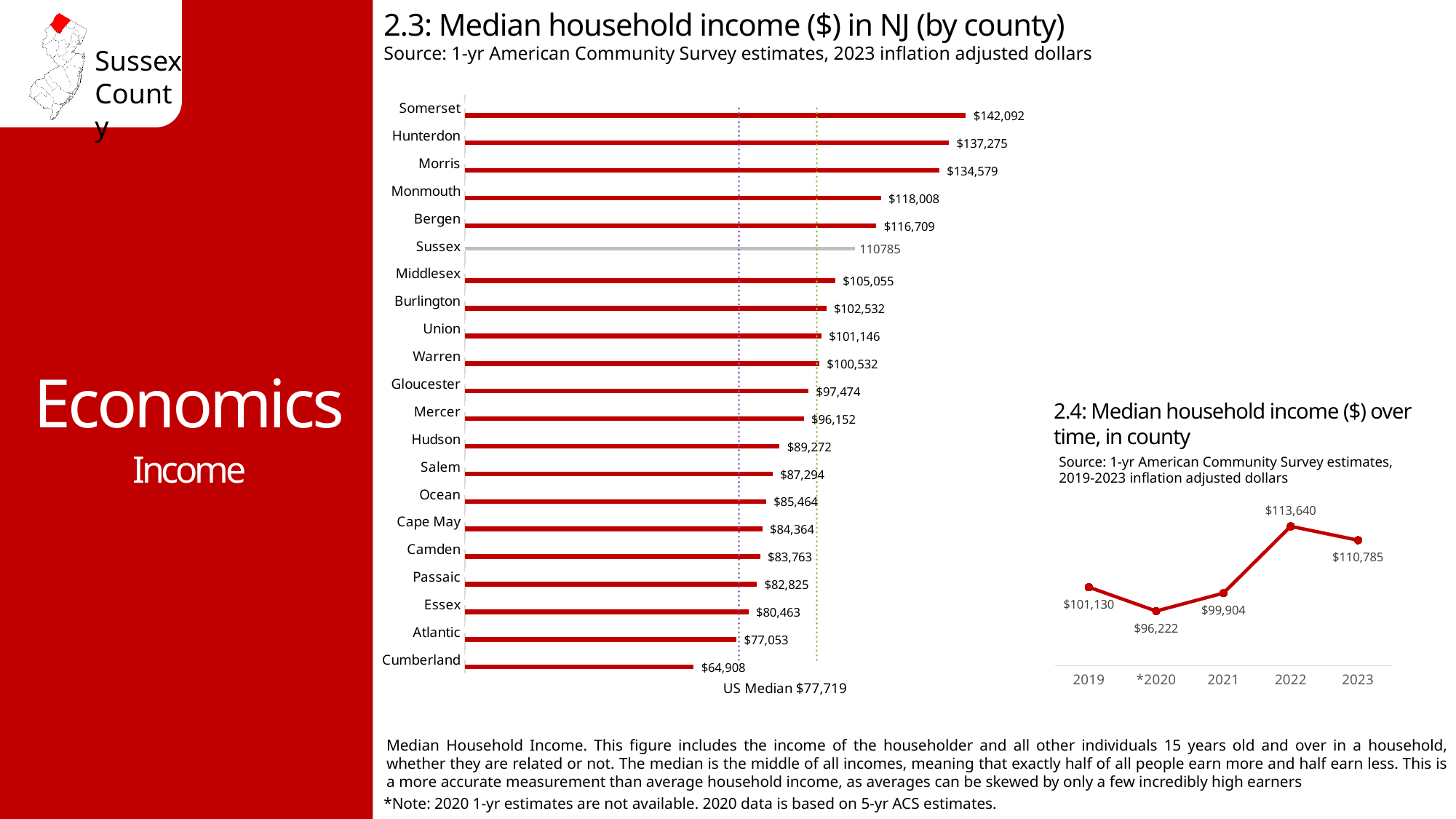
In chart 2.4 (Median household income over time), which year has the lowest median household income? *2020 In chart 2.3 (Median household income by county), which has a higher median household income, Bergen or Hudson? Bergen In chart 2.3 (Median household income by county), which county has the lowest median household income? Cumberland In chart 2.3 (Median household income by county), how many counties are shown? 21 In chart 2.3 (Median household income by county), what value is shown for Sussex? 110785 In chart 2.3 (Median household income by county), which county has the highest median household income? Somerset In chart 2.3 (Median household income by county), what is the difference between Somerset's and Cumberland's median household income? $77,184 In chart 2.4 (Median household income over time), how many years are plotted? 5 In chart 2.3 (Median household income by county), what is the median household income for Morris? $134,579 In chart 2.4 (Median household income over time), what is the difference between the 2022 and 2021 values? $13,736 In chart 2.4 (Median household income over time), what is the value for 2022? $113,640 What kind of chart is chart 2.3 (Median household income by county)? Bar chart